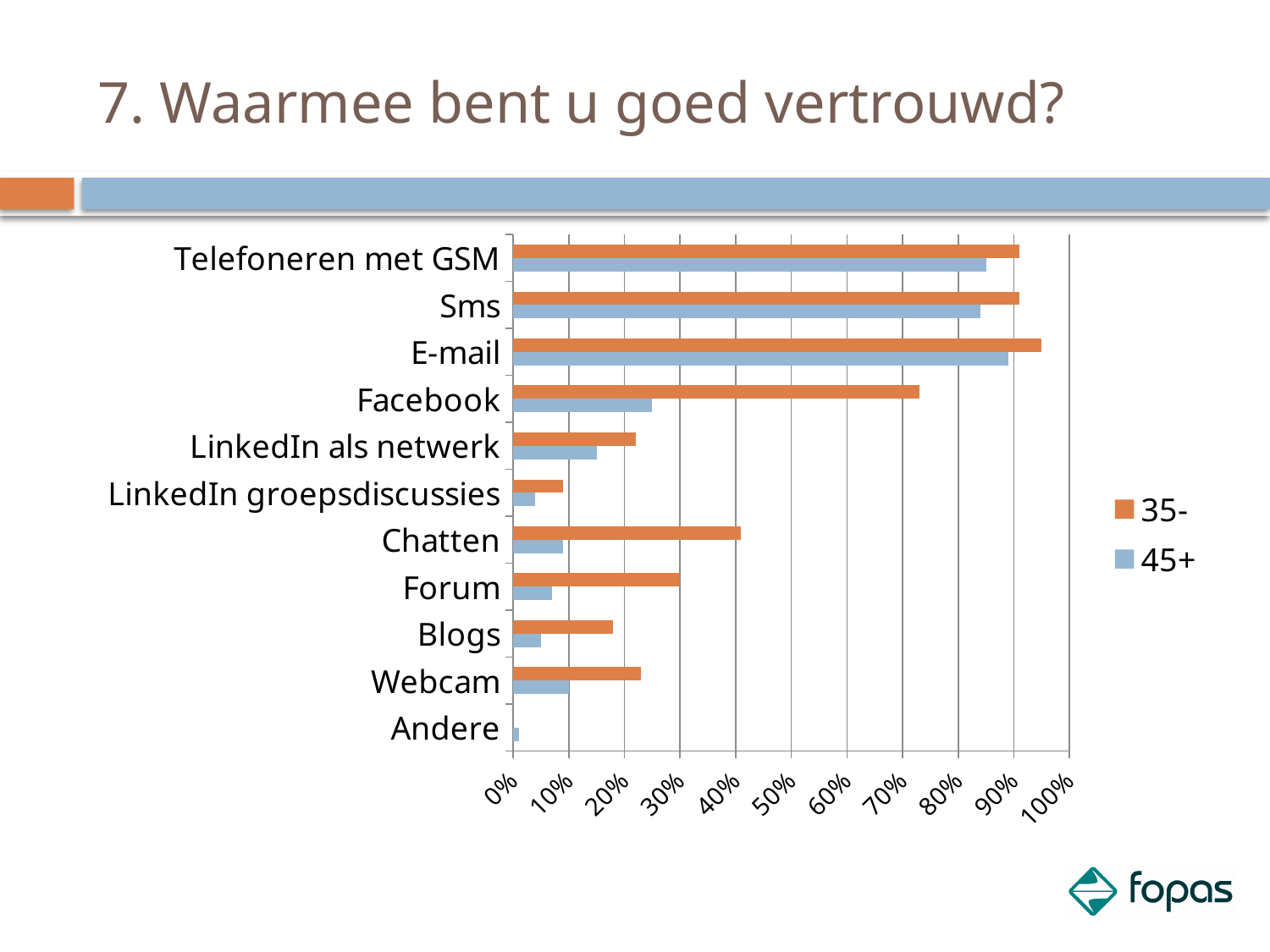
How many series does the legend list? 2 Is the value for Chatten in the 35- series greater or less than 30%? greater Is the value for Forum in the 45+ series greater or less than 10%? less For Facebook, which series has the larger value, 35- or 45+? 35- Which category has the lowest value for the 35- series? Andere Which category has the highest value for the 45+ series? E-mail Is the value for Facebook in the 35- series greater or less than 60%? greater Which category has the highest value for the 35- series? E-mail How many categories are shown on the chart? 11 Which colour represents the 45+ series in the chart? blue What kind of chart is shown on the slide? bar chart